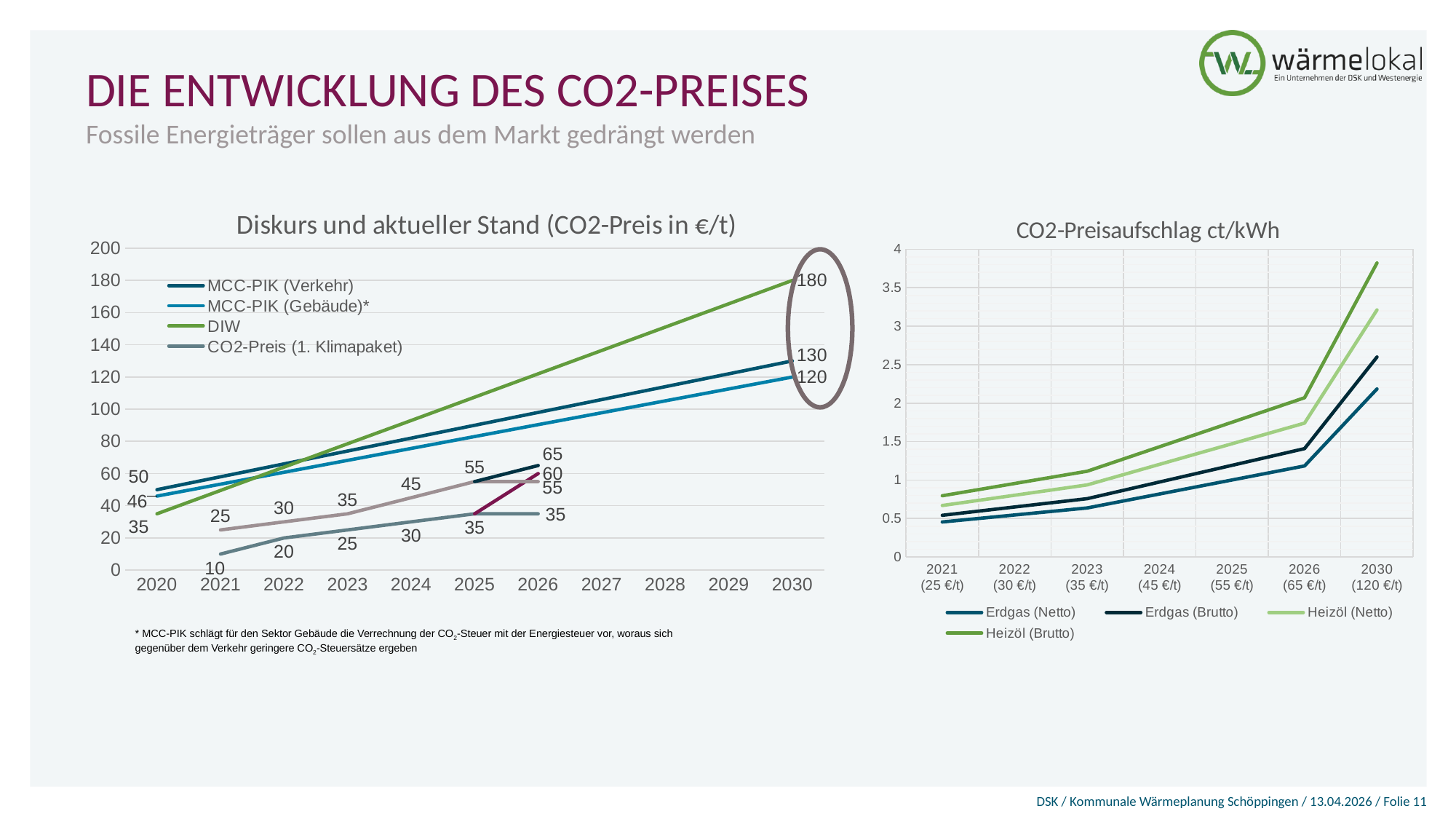
In the chart 'Diskurs und aktueller Stand (CO2-Preis in €/t)', which series has the highest value in 2030? DIW How many series does the legend of the chart 'Diskurs und aktueller Stand (CO2-Preis in €/t)' list? 4 In the chart 'Diskurs und aktueller Stand (CO2-Preis in €/t)', what value does the DIW series reach in 2030? 180 How many years are shown on the x axis of the chart 'CO2-Preisaufschlag ct/kWh'? 7 How many series does the legend of the chart 'CO2-Preisaufschlag ct/kWh' list? 4 In the chart 'Diskurs und aktueller Stand (CO2-Preis in €/t)', what is the value of CO2-Preis (1. Klimapaket) in 2021? 10 In the chart 'Diskurs und aktueller Stand (CO2-Preis in €/t)', what is the value of MCC-PIK (Gebäude)* in 2030? 120 What kind of chart is 'Diskurs und aktueller Stand (CO2-Preis in €/t)'? Line chart In the chart 'Diskurs und aktueller Stand (CO2-Preis in €/t)', what is the value of MCC-PIK (Verkehr) in 2030? 130 In the chart 'CO2-Preisaufschlag ct/kWh', is the value for Heizöl (Brutto) in 2030 greater or less than 3.5? greater In the chart 'Diskurs und aktueller Stand (CO2-Preis in €/t)', what is the difference between the DIW value and the MCC-PIK (Verkehr) value in 2030? 50 In the chart 'CO2-Preisaufschlag ct/kWh', which series has the highest value in 2030? Heizöl (Brutto)